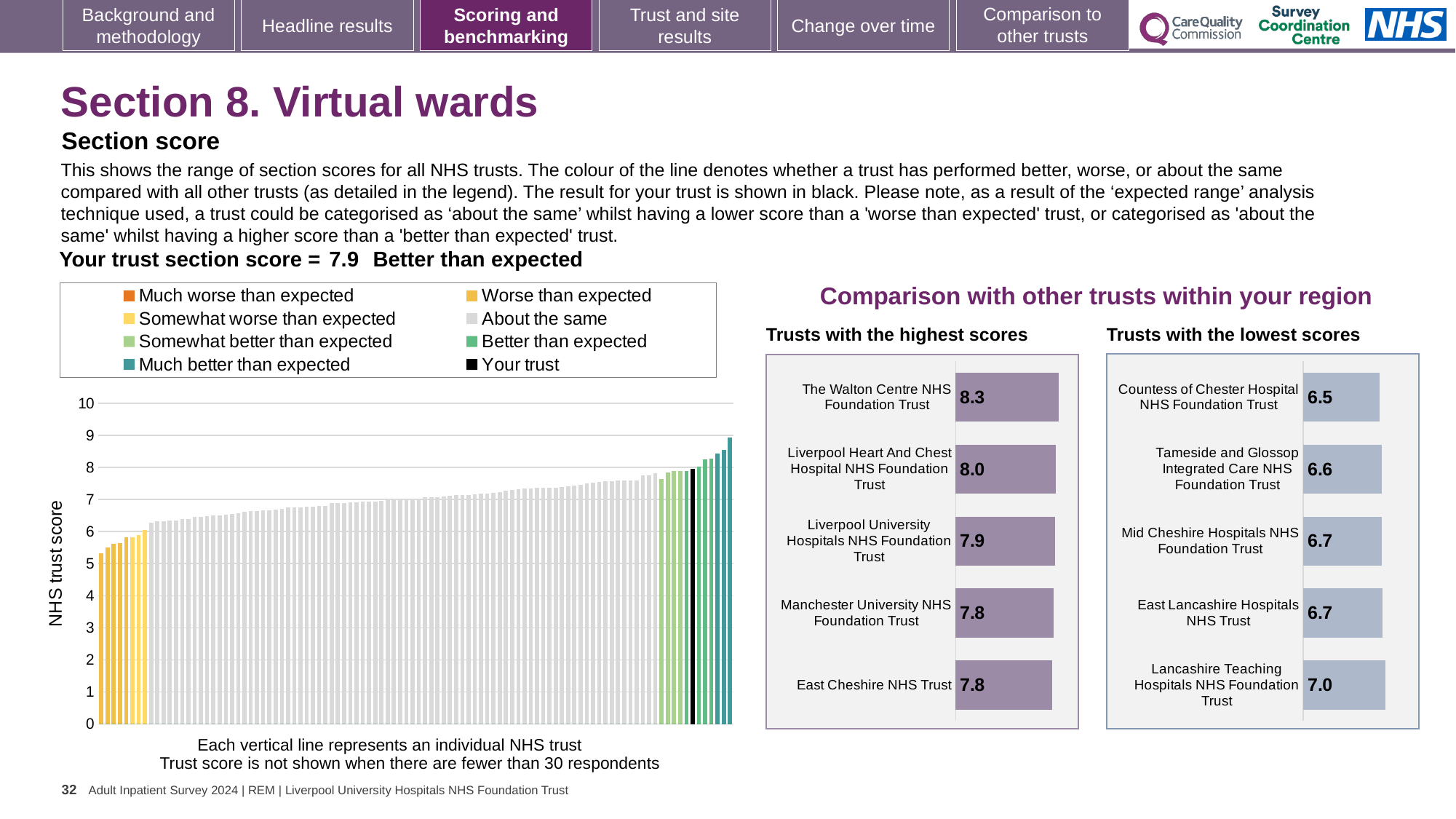
How many entries does the legend of the large chart on the left list? 8 How many trusts are shown in the 'Trusts with the lowest scores' chart? 5 In the 'Trusts with the lowest scores' chart, which trust has the lowest score? Countess of Chester Hospital NHS Foundation Trust In the 'Trusts with the highest scores' chart, what is the score for Liverpool Heart And Chest Hospital NHS Foundation Trust? 8.0 In the 'Trusts with the lowest scores' chart, what is the score for Lancashire Teaching Hospitals NHS Foundation Trust? 7.0 In the large chart on the left, do the bar values rise or fall from left to right? Rise In the 'Trusts with the lowest scores' chart, which has the larger score: Lancashire Teaching Hospitals NHS Foundation Trust or Tameside and Glossop Integrated Care NHS Foundation Trust? Lancashire Teaching Hospitals NHS Foundation Trust What type of chart is the large chart on the left showing NHS trust scores? Bar chart In the 'Trusts with the highest scores' chart, what is the difference between the scores of The Walton Centre NHS Foundation Trust and East Cheshire NHS Trust? 0.5 In the 'Trusts with the highest scores' chart, which trust has the highest score? The Walton Centre NHS Foundation Trust In the large chart on the left, is the value of the leftmost bar greater or less than 6? less In the 'Trusts with the highest scores' chart, what is the score for The Walton Centre NHS Foundation Trust? 8.3